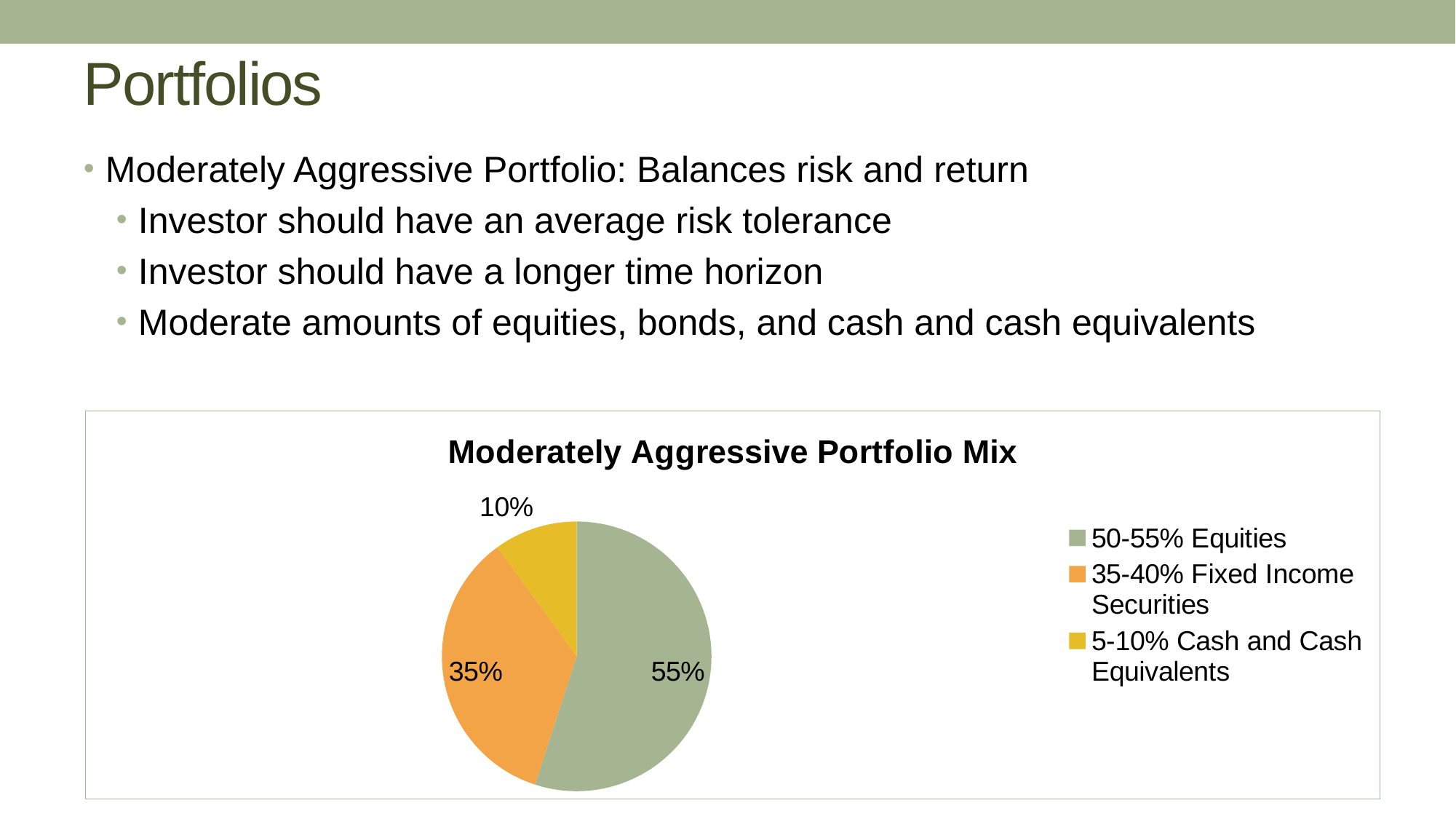
What kind of chart is shown on the slide? pie chart What is the difference between the Equities slice and the Fixed Income Securities slice? 20% Which slice of the pie is the largest? 50-55% Equities How many slices does the pie chart have? 3 What percentage is shown for the 50-55% Equities slice? 55% How many entries does the legend list? 3 What percentage is shown for the 35-40% Fixed Income Securities slice? 35% Which slice of the pie is the smallest? 5-10% Cash and Cash Equivalents What is the title of the chart? Moderately Aggressive Portfolio Mix What percentage is shown for the 5-10% Cash and Cash Equivalents slice? 10% Which is larger, the Fixed Income Securities slice or the Cash and Cash Equivalents slice? 35-40% Fixed Income Securities What colour is the 5-10% Cash and Cash Equivalents slice? yellow